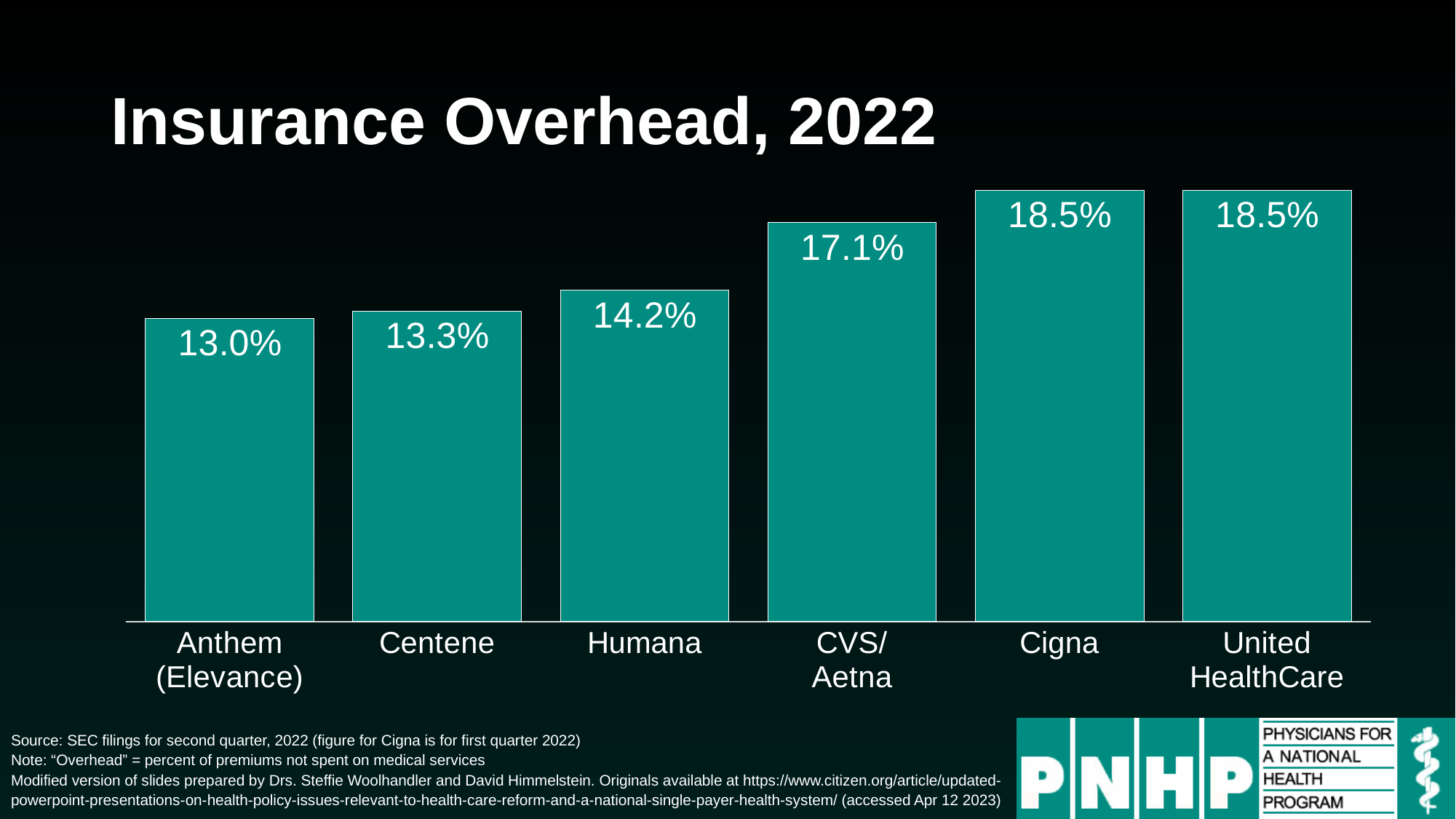
What type of chart is shown on the slide? Bar chart What is the insurance overhead value shown for Humana? 14.2% What is the title of the chart? Insurance Overhead, 2022 What is the difference between the overhead for Cigna and the overhead for Anthem (Elevance)? 5.5% What is the insurance overhead value shown for CVS/Aetna? 17.1% How many insurers are shown in the chart? 6 Which has a higher overhead, Centene or CVS/Aetna? CVS/Aetna What is the insurance overhead value shown for Anthem (Elevance)? 13.0% What is the insurance overhead value shown for Centene? 13.3% What is the highest overhead value shown in the chart? 18.5% What is the difference between the overhead for CVS/Aetna and the overhead for Humana? 2.9% Which insurer has the lowest overhead in the chart? Anthem (Elevance)